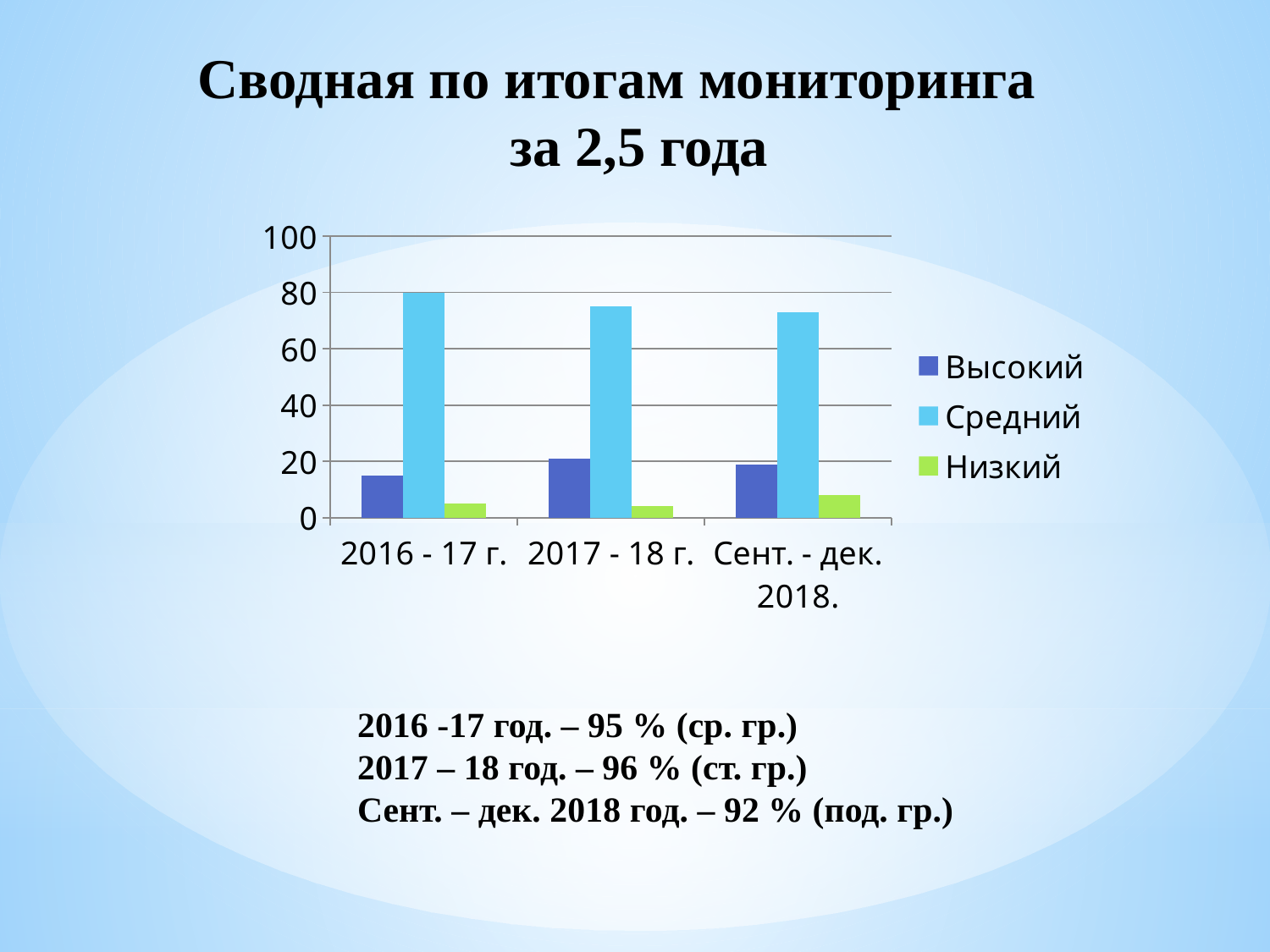
How many categories are shown on the x axis? 3 What kind of chart is shown on the slide? bar chart How many series does the legend list? 3 What are the three series named in the legend? Высокий, Средний, Низкий In which category is the Средний series highest? 2016 - 17 г. Is the value for Высокий in 2016 - 17 г. greater or less than 20? less What is the value for Средний in 2016 - 17 г.? 80 Which is larger: Высокий in 2017 - 18 г. or Высокий in 2016 - 17 г.? Высокий in 2017 - 18 г. Does the Средний series rise or fall across the categories from left to right? fall Is the value for Средний in Сент. - дек. 2018. greater or less than 60? greater In which category is the Высокий series lowest? 2016 - 17 г. In which category is the Низкий series highest? Сент. - дек. 2018.